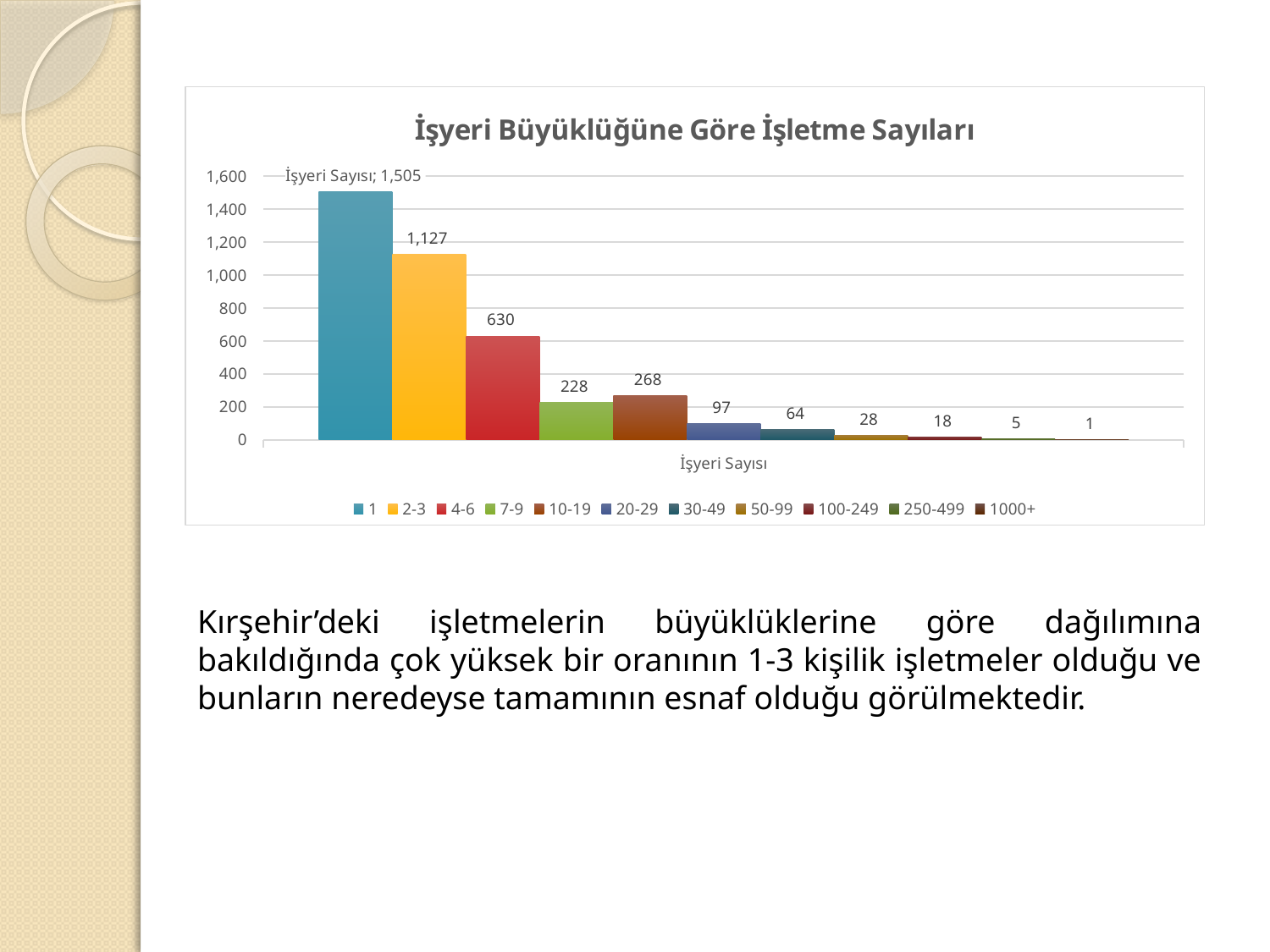
What is the difference between the values for "1" and "2-3"? 378 What type of chart is shown on the slide? bar chart How many entries does the legend list? 11 How many categories (bars) are shown in the chart? 11 What is the title of the chart? İşyeri Büyüklüğüne Göre İşletme Sayıları What is the value for the category "1"? 1,505 Which is larger, the value for "7-9" or the value for "10-19"? 10-19 What is the value for the category "50-99"? 28 Which category has the lowest value? 1000+ What is the value for the category "4-6"? 630 Which category has the highest value? 1 What is the value for the category "10-19"? 268